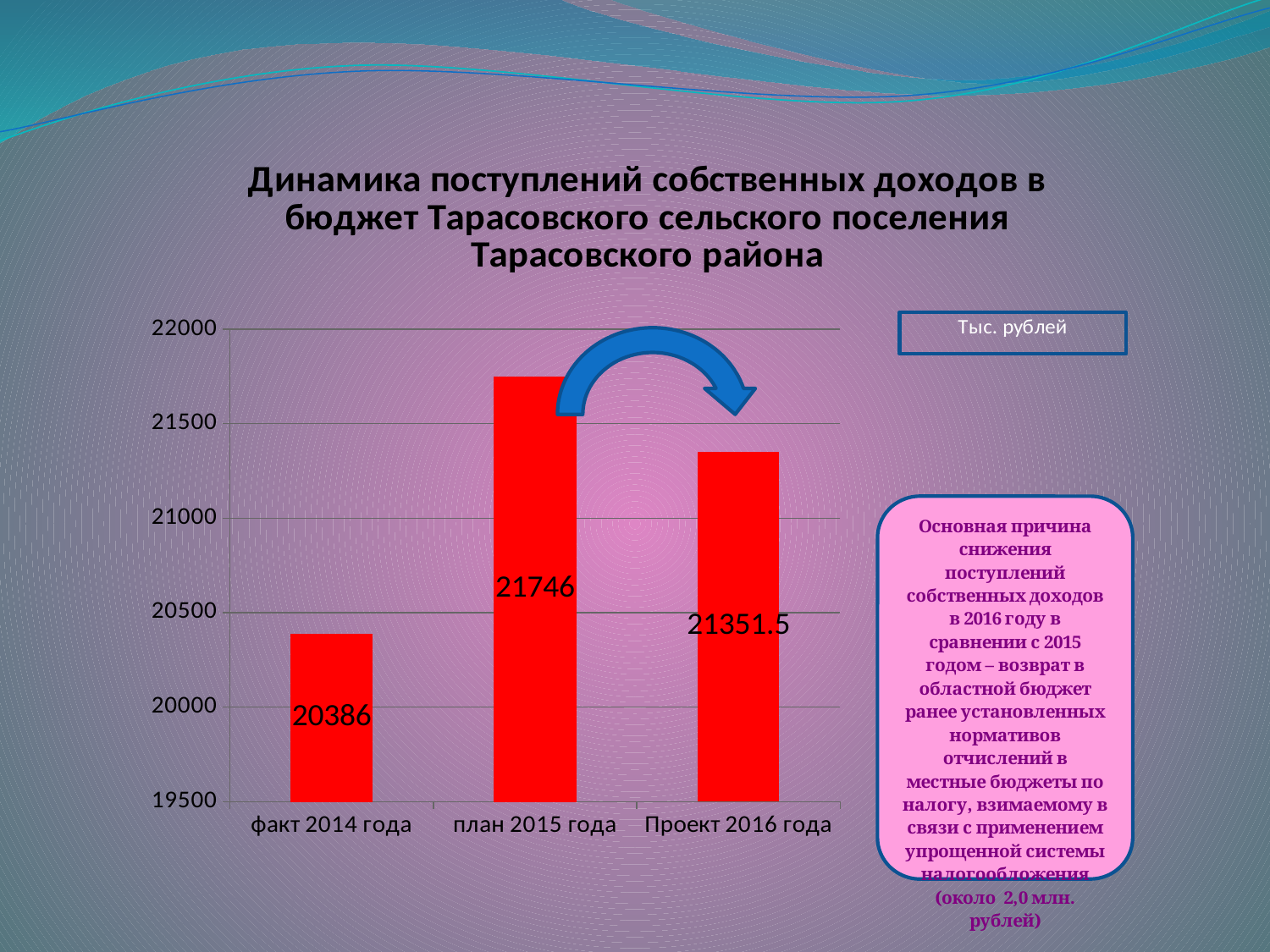
What is the value for Проект 2016 года? 21351.5 Is the value for факт 2014 года greater or less than 20500? less What kind of chart is shown on the slide? bar chart What is the difference between план 2015 года and Проект 2016 года? 394.5 What unit of measurement is indicated for the chart values? Тыс. рублей What is the value for факт 2014 года? 20386 How many categories are shown on the x axis? 3 What is the difference between план 2015 года and факт 2014 года? 1360 Which category has the lowest value? факт 2014 года What is the value for план 2015 года? 21746 Which is larger, the value for Проект 2016 года or the value for факт 2014 года? Проект 2016 года Which category has the highest value? план 2015 года